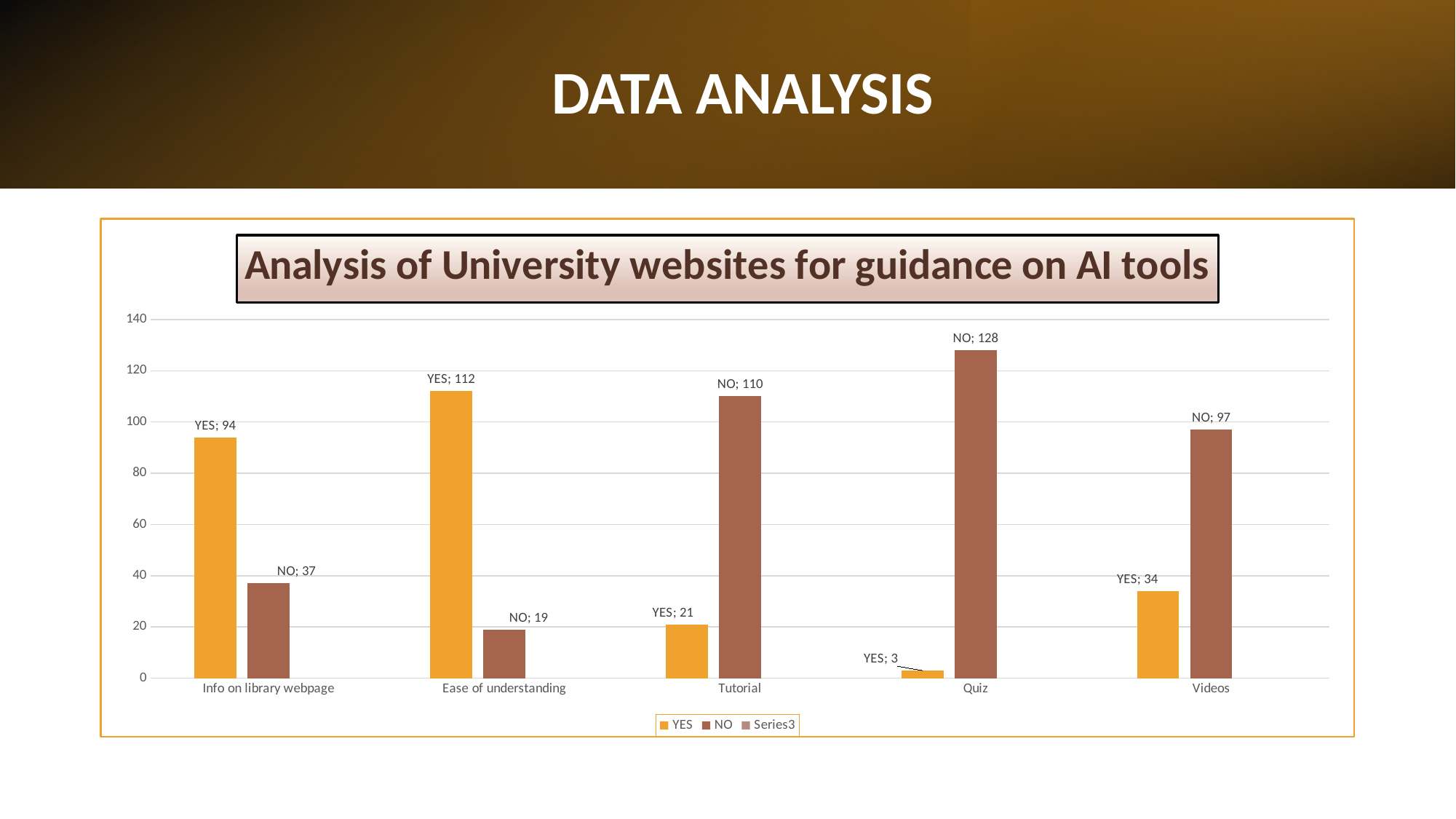
What is the YES value for Videos? 34 What is the title of the chart? Analysis of University websites for guidance on AI tools Which is larger for Ease of understanding, the YES value or the NO value? YES What kind of chart is shown on the slide? Bar chart Which category has the highest NO value? Quiz Which category has the lowest YES value? Quiz What is the YES value for Info on library webpage? 94 What is the difference between the NO and YES values for Tutorial? 89 How many categories are shown on the x axis? 5 What colour are the YES bars? Orange What is the NO value for Quiz? 128 How many series does the legend list? 3